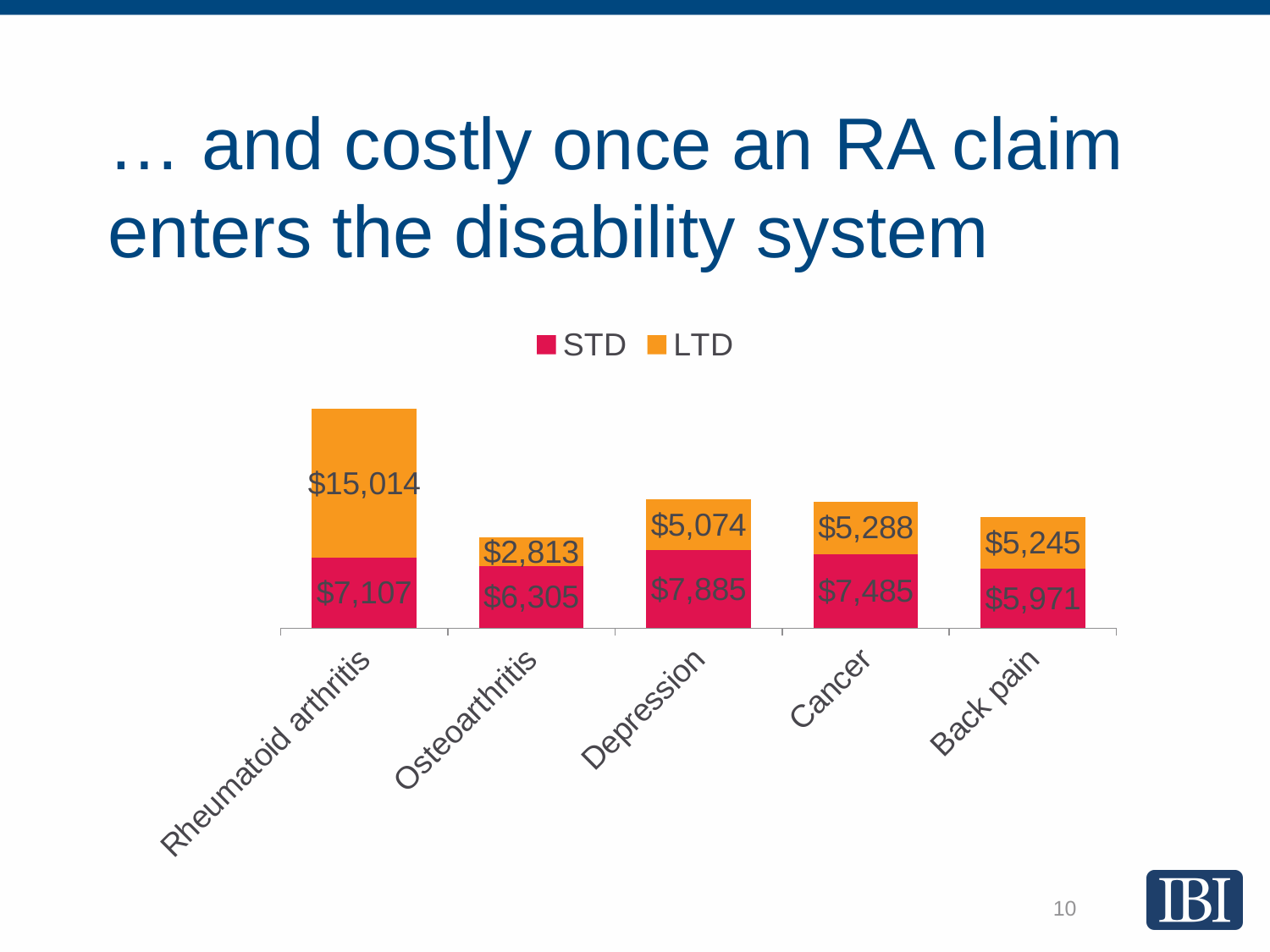
Which category has the lowest STD value? Back pain Which is larger, the STD value for Cancer or the STD value for Osteoarthritis? Cancer What kind of chart is shown on the slide? Stacked bar chart What is the STD value for Depression? $7,885 What is the total of the STD and LTD values for Rheumatoid arthritis? $22,121 What is the difference between the LTD values for Rheumatoid arthritis and Osteoarthritis? $12,201 Which category has the highest LTD value? Rheumatoid arthritis How many series does the legend list? 2 What is the LTD value for Osteoarthritis? $2,813 What is the STD value for Back pain? $5,971 What is the LTD value for Rheumatoid arthritis? $15,014 How many categories are shown on the x axis? 5